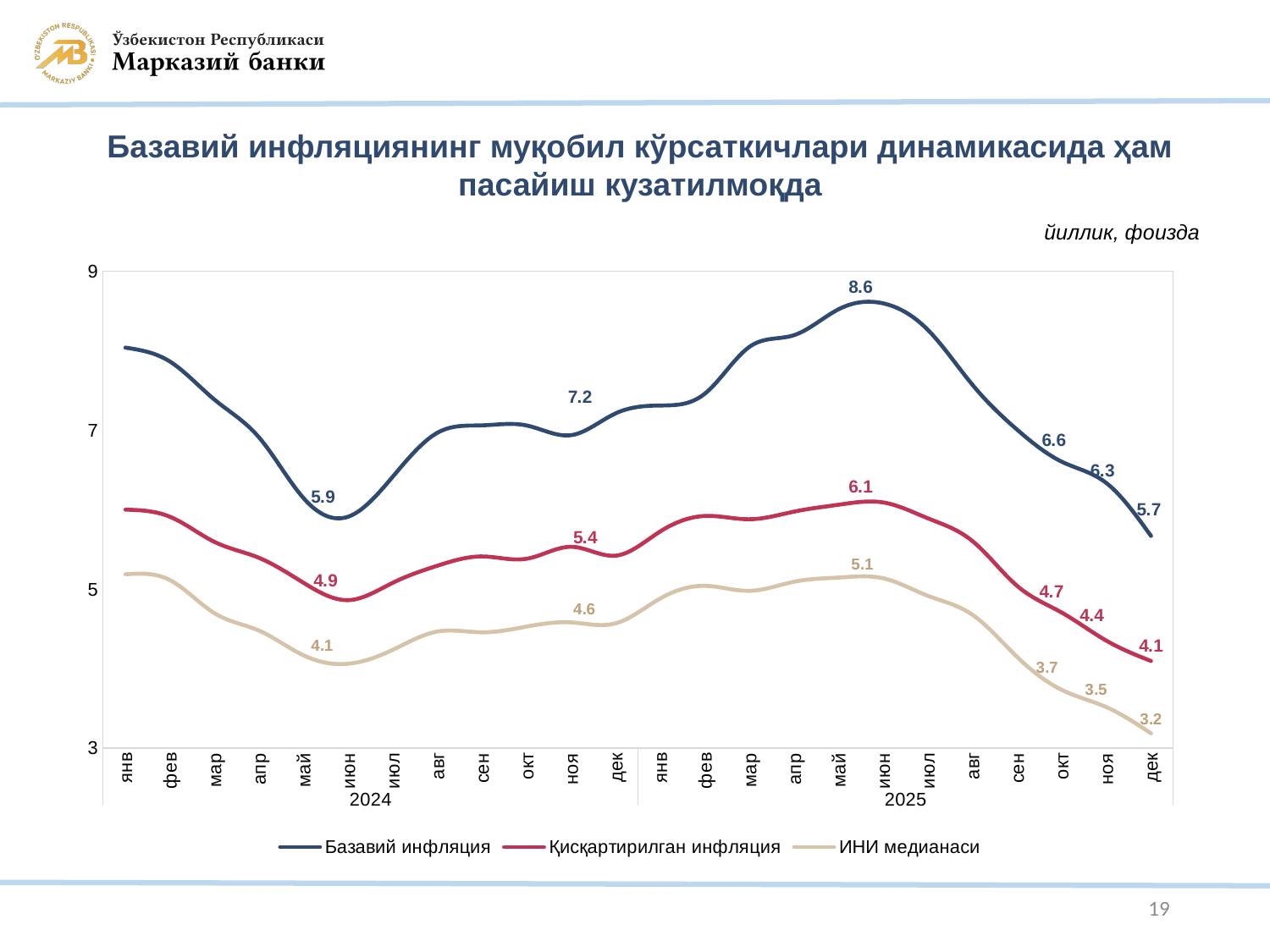
Is the value of Базавий инфляция in January 2024 greater or less than 7? greater What is the value of Қисқартирилган инфляция in October 2025? 4.7 What is the value of ИНИ медианаси in December 2025? 3.2 Which is larger in December 2025: Қисқартирилган инфляция or ИНИ медианаси? Қисқартирилган инфляция What is the difference between Базавий инфляция and Қисқартирилган инфляция in December 2025? 1.6 How many series does the legend list? 3 What kind of chart is shown on the slide? line chart By how much did Базавий инфляция fall from November 2025 (6.3) to December 2025 (5.7)? 0.6 What is the value of ИНИ медианаси in October 2025? 3.7 What is the highest labelled value of Базавий инфляция on the chart? 8.6 What is the value of Қисқартирилган инфляция in December 2025? 4.1 What is the value of Базавий инфляция in December 2025? 5.7